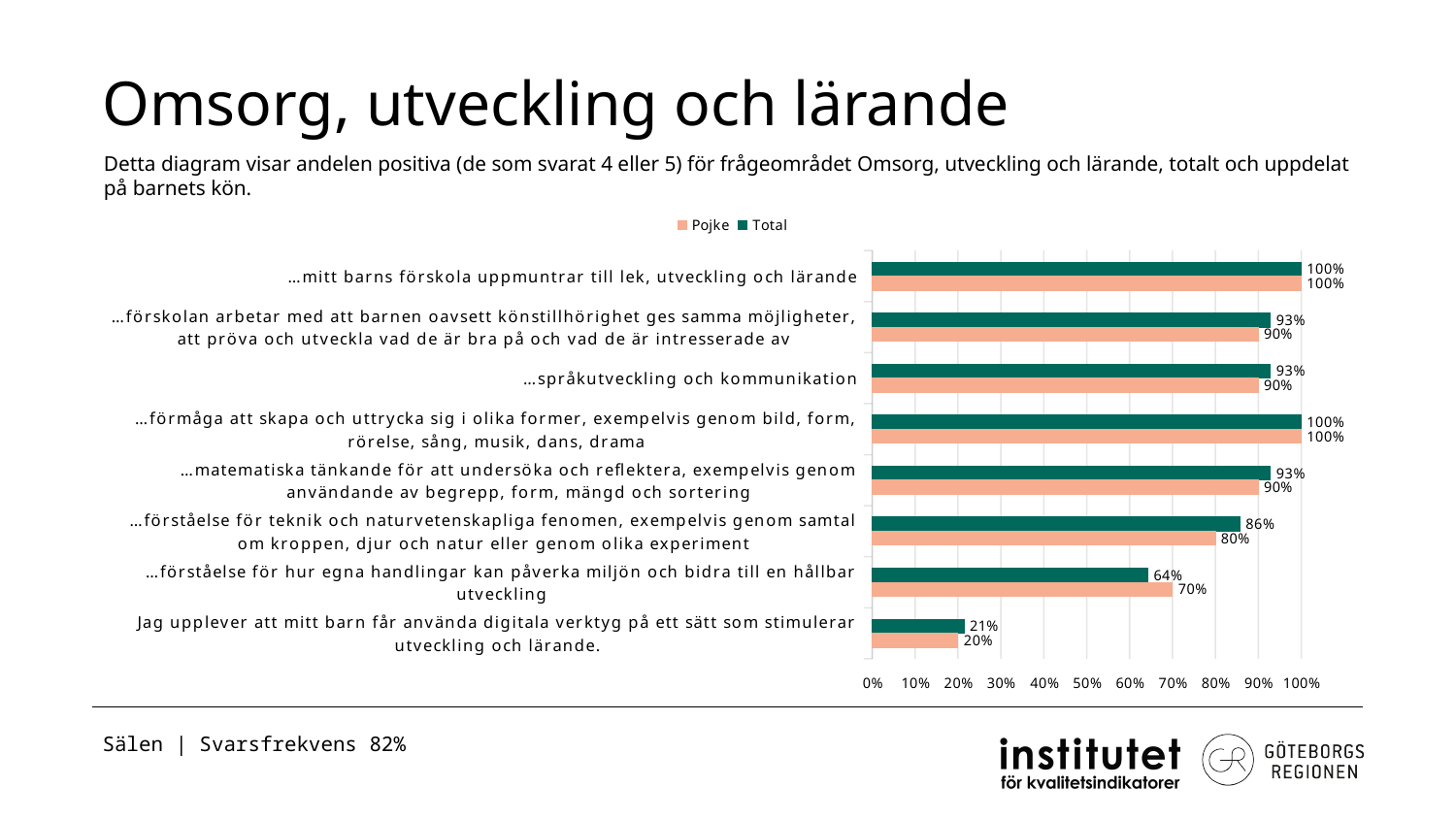
For "…förståelse för hur egna handlingar kan påverka miljön och bidra till en hållbar utveckling", which is larger, the Pojke value or the Total value? Pojke What is the Total value for "…språkutveckling och kommunikation"? 93% What is the difference between the Total and Pojke values for "…förståelse för teknik och naturvetenskapliga fenomen, exempelvis genom samtal om kroppen, djur och natur eller genom olika experiment"? 6 percentage points How many categories (statements) are plotted in the chart? 8 How many series does the legend list? 2 What is the Total value for "Jag upplever att mitt barn får använda digitala verktyg på ett sätt som stimulerar utveckling och lärande."? 21% What is the Pojke value for "…förståelse för hur egna handlingar kan påverka miljön och bidra till en hållbar utveckling"? 70% What is the Pojke value for "…förståelse för teknik och naturvetenskapliga fenomen, exempelvis genom samtal om kroppen, djur och natur eller genom olika experiment"? 80% Is the Total value for "…förståelse för hur egna handlingar kan påverka miljön och bidra till en hållbar utveckling" greater or less than 70%? less What kind of chart is shown on the slide? bar chart Which series is shown in dark green in the chart? Total Which category has the lowest Total value? Jag upplever att mitt barn får använda digitala verktyg på ett sätt som stimulerar utveckling och lärande.